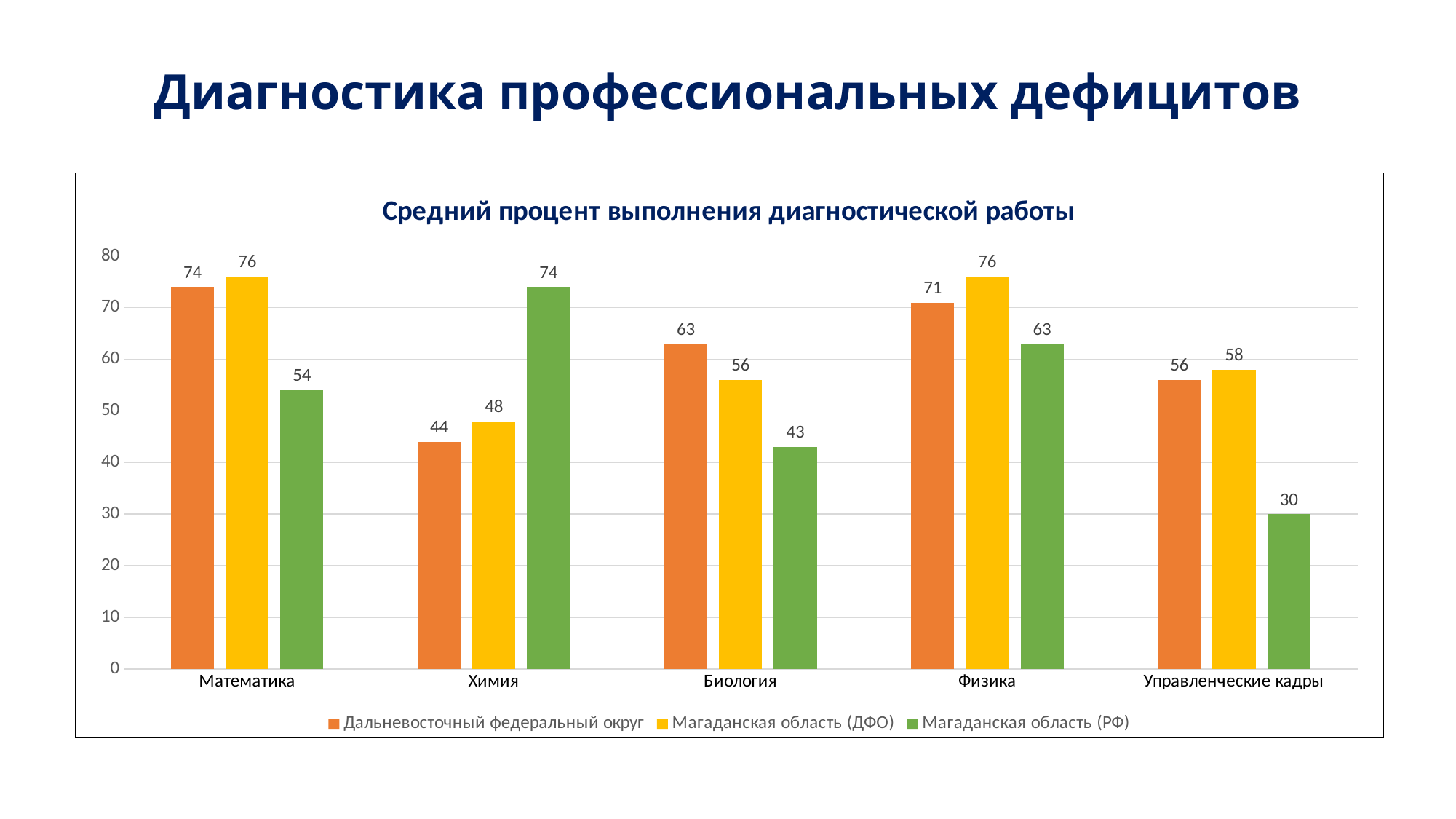
What is the value for Управленческие кадры in the Магаданская область (ДФО) series? 58 What is the value for Химия in the Магаданская область (РФ) series? 74 How many series does the legend list? 3 What is the title of the chart? Средний процент выполнения диагностической работы How many categories are shown on the x axis? 5 What kind of chart is shown on the slide? bar chart For Биология, which is larger: the Дальневосточный федеральный округ value or the Магаданская область (ДФО) value? Дальневосточный федеральный округ Which category has the lowest value in the Магаданская область (РФ) series? Управленческие кадры What is the difference between the Магаданская область (ДФО) and Магаданская область (РФ) values for Физика? 13 Which category has the lowest value in the Дальневосточный федеральный округ series? Химия What is the value for Математика in the Дальневосточный федеральный округ series? 74 Which colour represents the Магаданская область (РФ) series? green